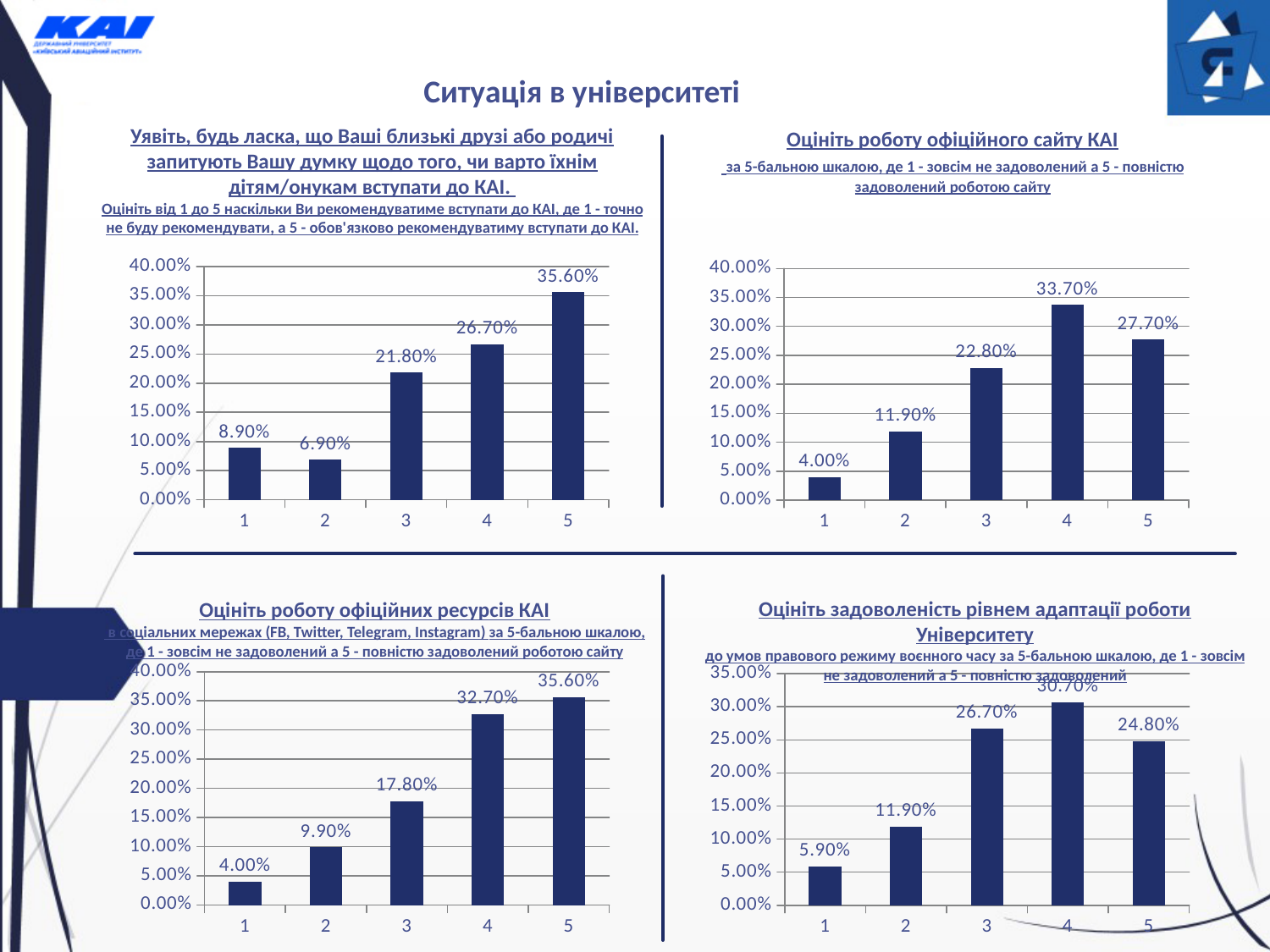
In the top-left chart (recommending entering KAI), which category has the lowest value? 2 In the top-right chart (Оцініть роботу офіційного сайту КАІ), which is larger: the value for category 4 or category 5? category 4 In the top-left chart (recommending entering KAI), what is the value for category 5? 35.60% In the bottom-right chart (Оцініть задоволеність рівнем адаптації роботи Університету), what is the difference between the values for category 4 and category 5? 5.90% What type of chart is the top-left chart? bar chart In the top-left chart (recommending entering KAI), what is the difference between the values for category 5 and category 4? 8.90% In the top-right chart (Оцініть роботу офіційного сайту КАІ), what is the value for category 2? 11.90% In the bottom-right chart (Оцініть задоволеність рівнем адаптації роботи Університету), what is the value for category 1? 5.90% How many categories are shown on the x axis of the bottom-right chart? 5 In the top-right chart (Оцініть роботу офіційного сайту КАІ), which category has the highest value? 4 In the bottom-left chart (Оцініть роботу офіційних ресурсів КАІ), what is the value for category 3? 17.80% In the bottom-left chart (Оцініть роботу офіційних ресурсів КАІ), do the values rise or fall from category 1 to category 5? rise